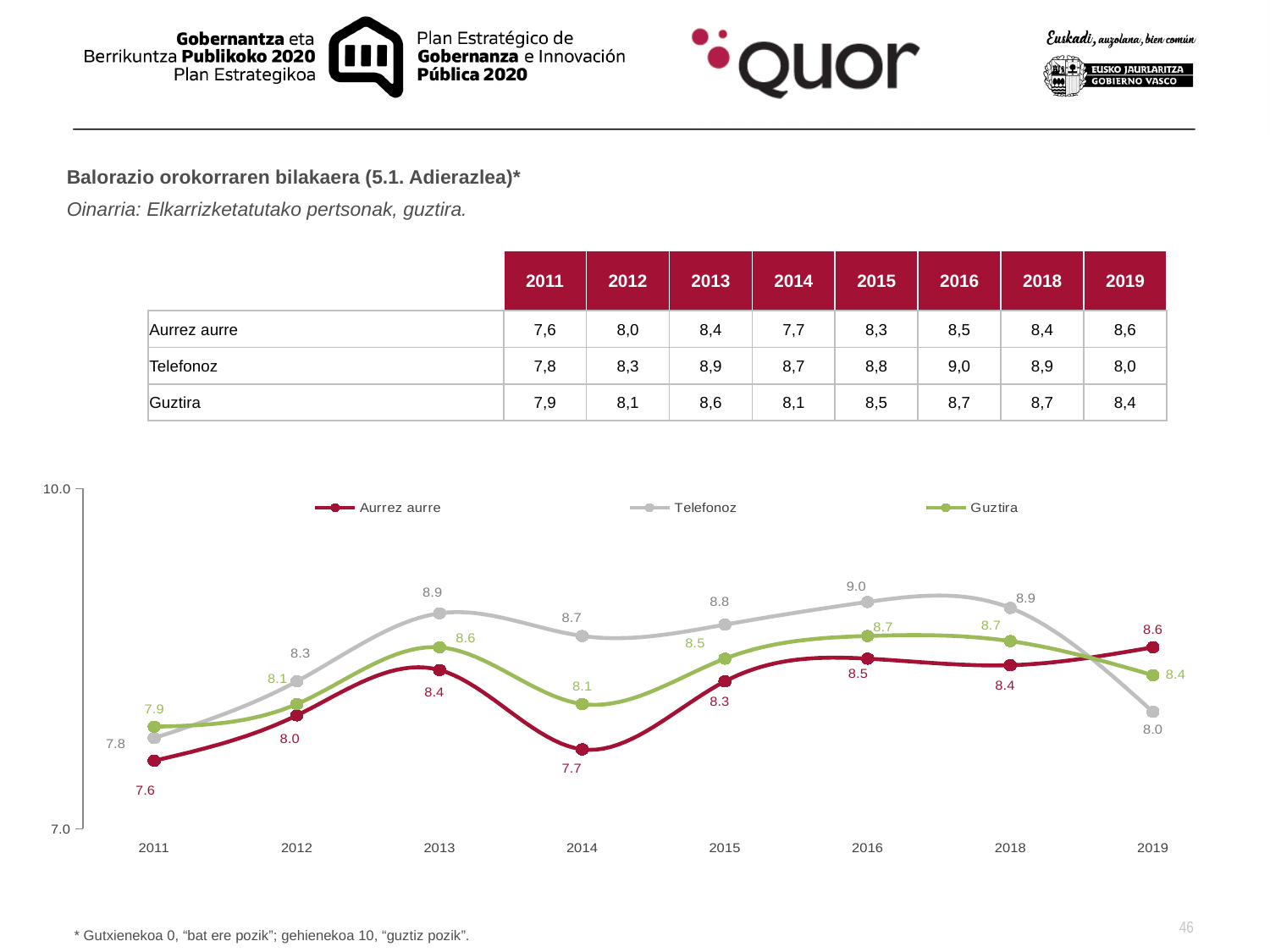
What is the value for Telefonoz in 2016 on the chart? 9.0 How many years are plotted along the x axis of the chart? 8 Which series is drawn in green on the chart? Guztira In which year does the Aurrez aurre series have its lowest value? 2011 What kind of chart is shown on the slide? line chart In 2019, which series has the higher value, Aurrez aurre or Telefonoz? Aurrez aurre What is the value for Aurrez aurre in 2014 on the chart? 7.7 Does the Telefonoz series rise or fall between 2018 and 2019? fall In which year does the Telefonoz series reach its highest value? 2016 How many series does the chart legend list? 3 What is the value for Guztira in 2019 on the chart? 8.4 What is the difference between the Telefonoz and Aurrez aurre values in 2013? 0.5